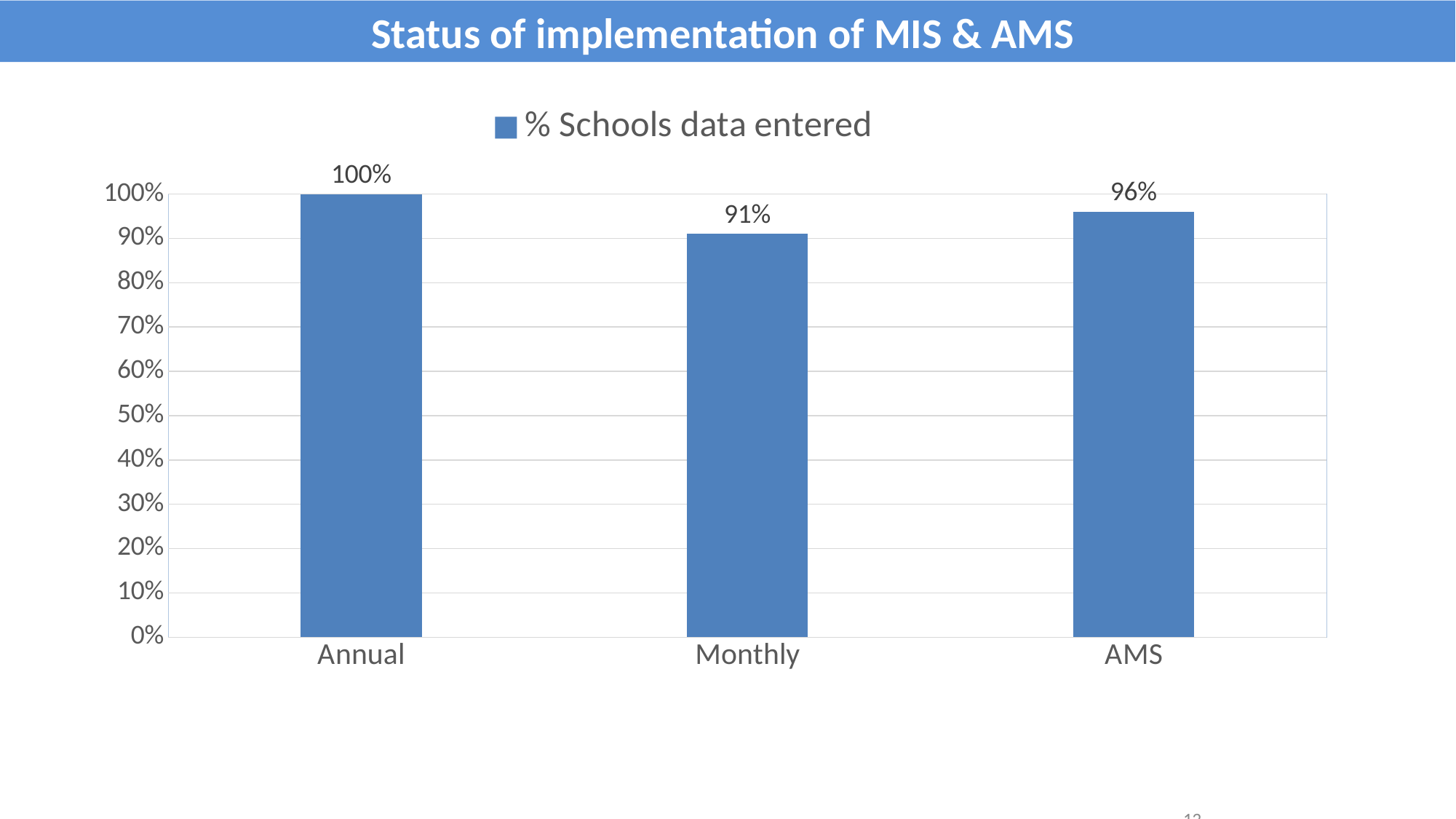
Is the value for Monthly greater or less than 90%? greater Which category has the lowest value? Monthly What kind of chart is shown on the slide? bar chart How many categories are shown on the x axis? 3 What is the value for Annual? 100% What is the value for AMS? 96% What is the difference between the values for Annual and Monthly? 9% Which category has the highest value? Annual What series name does the legend show? % Schools data entered Which is larger, the value for AMS or the value for Monthly? AMS What is the value for Monthly? 91% What is the difference between the values for AMS and Monthly? 5%